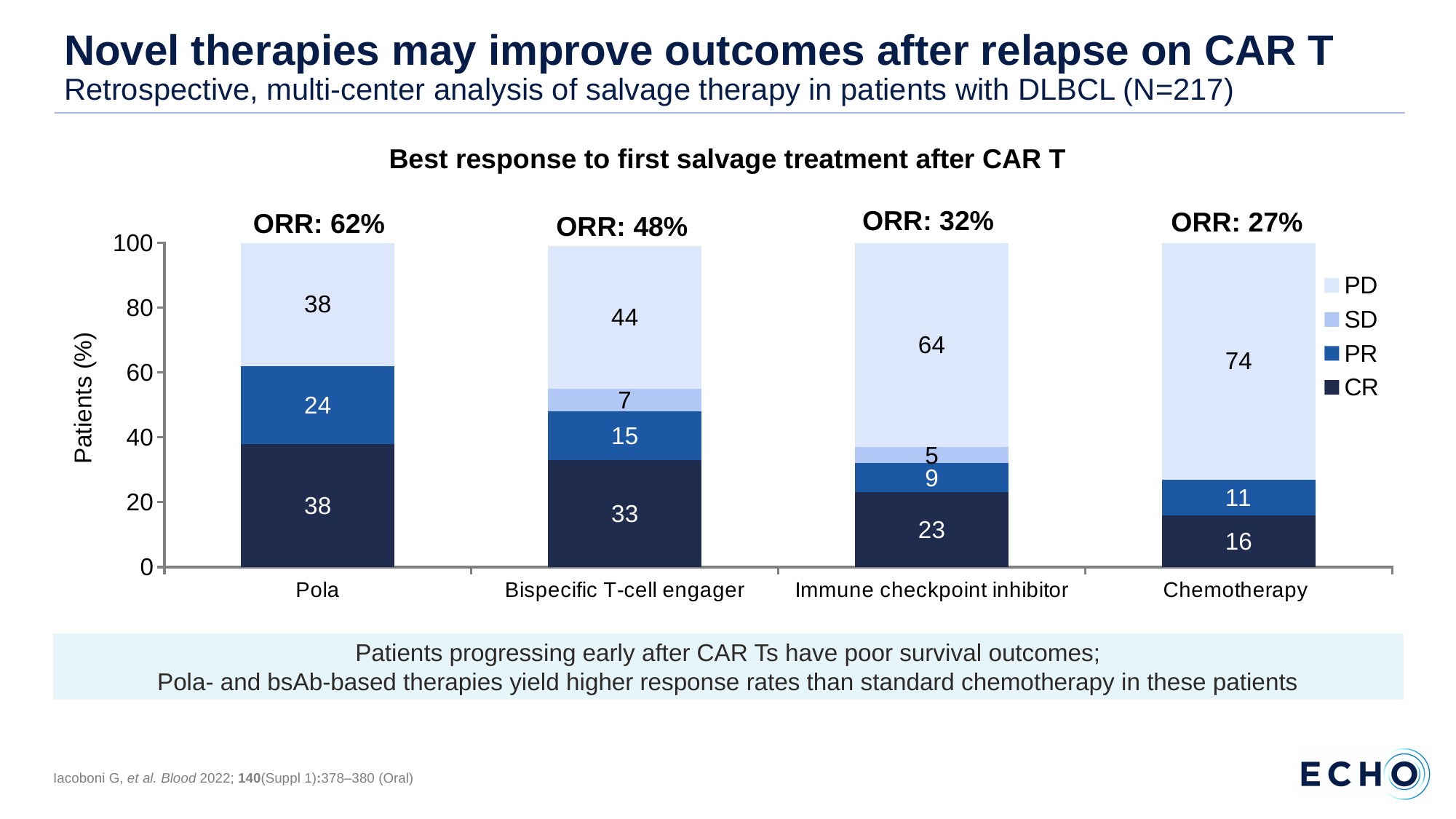
What is the PR value for Immune checkpoint inhibitor? 9 What is the ORR shown above the Immune checkpoint inhibitor bar? 32% What is the SD value for Bispecific T-cell engager? 7 Which is larger, the PR value for Pola or the PR value for Bispecific T-cell engager? Pola What is the difference between the PD values for Chemotherapy and Pola? 36 What kind of chart is shown? Stacked bar chart What is the PD value for Chemotherapy? 74 Which category has the lowest PD value? Pola Which category has the highest CR value? Pola How many series does the legend list? 4 What is the CR value for Pola? 38 How many categories are shown on the x axis? 4